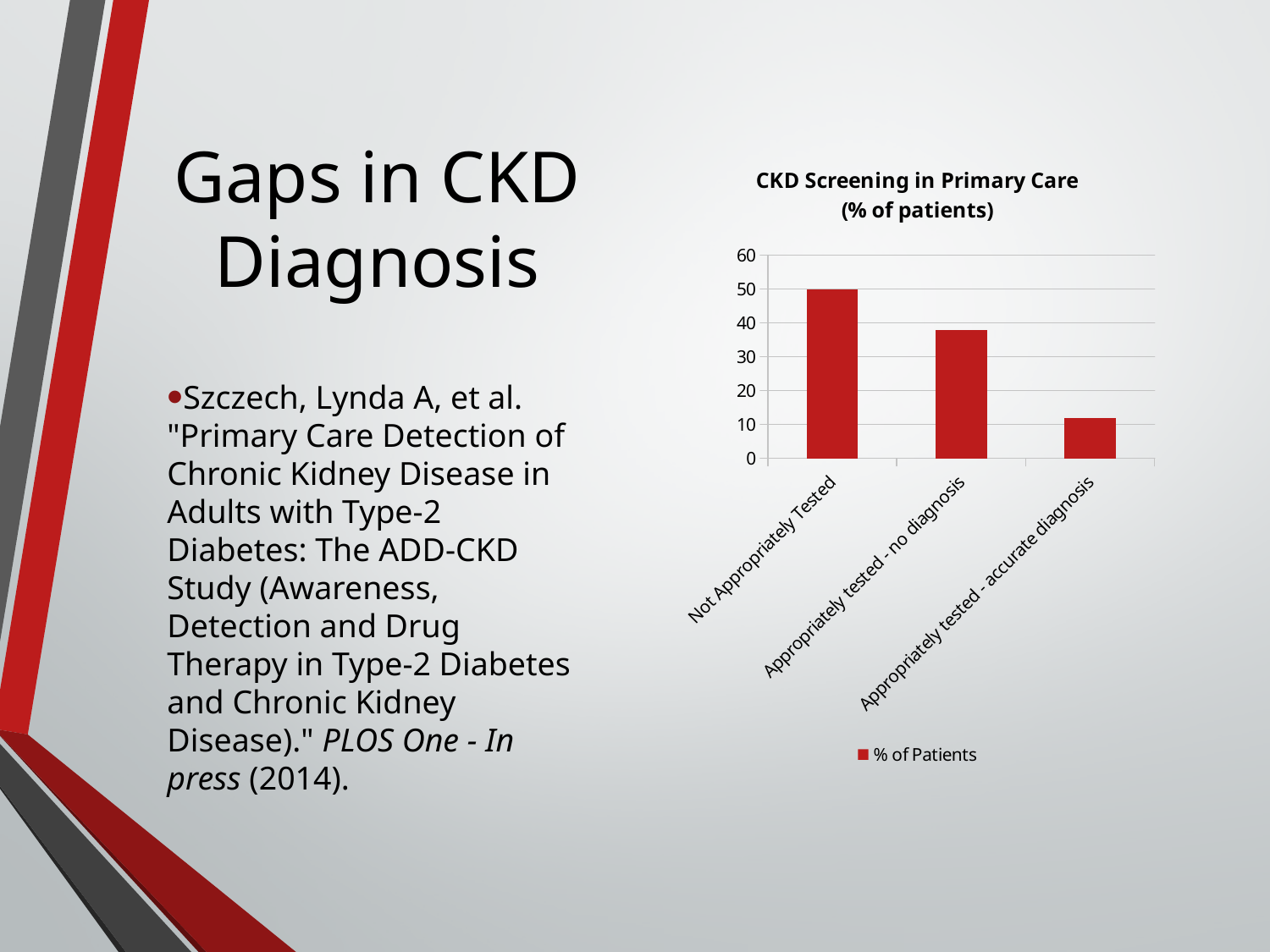
Which category has the highest value in the chart? Not Appropriately Tested Is the value for Appropriately tested - no diagnosis greater or less than 40? less Which category has the lowest value in the chart? Appropriately tested - accurate diagnosis What series name is shown in the chart legend? % of Patients What is the title of the chart? CKD Screening in Primary Care (% of patients) How many series does the chart legend list? 1 Is the value for Appropriately tested - accurate diagnosis greater or less than 20? less What type of chart is shown on the slide? bar chart Is the value for Appropriately tested - no diagnosis greater or less than 30? greater How many categories are shown on the x axis of the chart? 3 Which is larger, the value for Appropriately tested - no diagnosis or the value for Appropriately tested - accurate diagnosis? Appropriately tested - no diagnosis What is the value for Not Appropriately Tested? 50